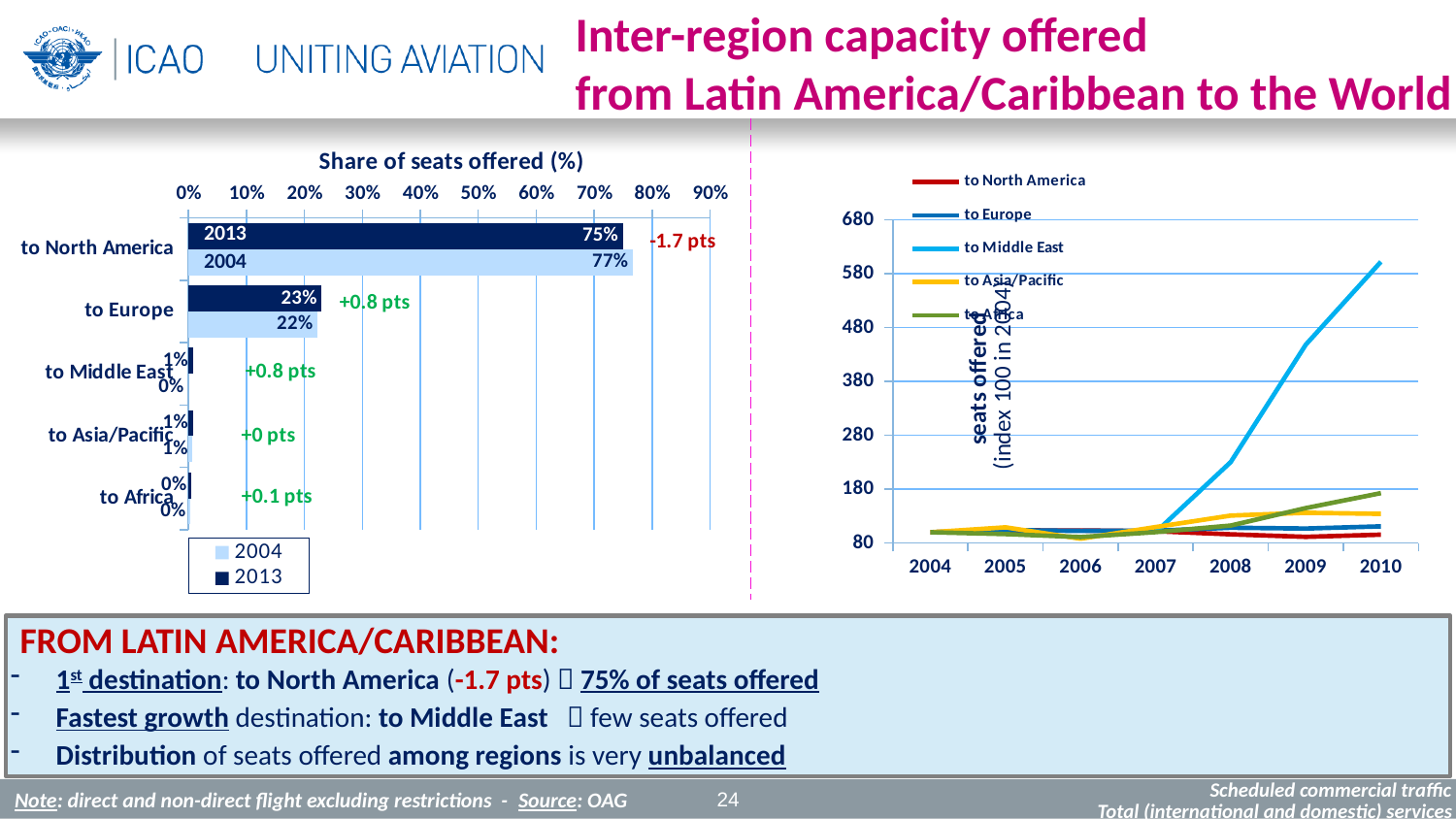
In the 'Share of seats offered (%)' chart, what is the 2004 share for 'to Europe'? 22% In the 'Share of seats offered (%)' chart, how many destination categories are shown? 5 In the line chart on the right, is the 2010 value for 'to Middle East' greater or less than 580? greater What kind of chart is the chart on the right side of the slide? Line chart In the 'Share of seats offered (%)' chart, what is the 2013 share for 'to North America'? 75% In the 'Share of seats offered (%)' chart, how many series does the legend list? 2 In the line chart on the right, how many series does the legend list? 5 In the 'Share of seats offered (%)' chart, what is the 2004 share for 'to North America'? 77% In the 'Share of seats offered (%)' chart, what is the 2013 share for 'to Europe'? 23% In the 'Share of seats offered (%)' chart, which is larger: the 2013 share for 'to Europe' or the 2004 share for 'to Europe'? 2013 (23%) In the 'Share of seats offered (%)' chart, what is the difference between the 2004 and 2013 shares for 'to North America'? 2% In the 'Share of seats offered (%)' chart, which destination has the highest share of seats offered in 2013? to North America